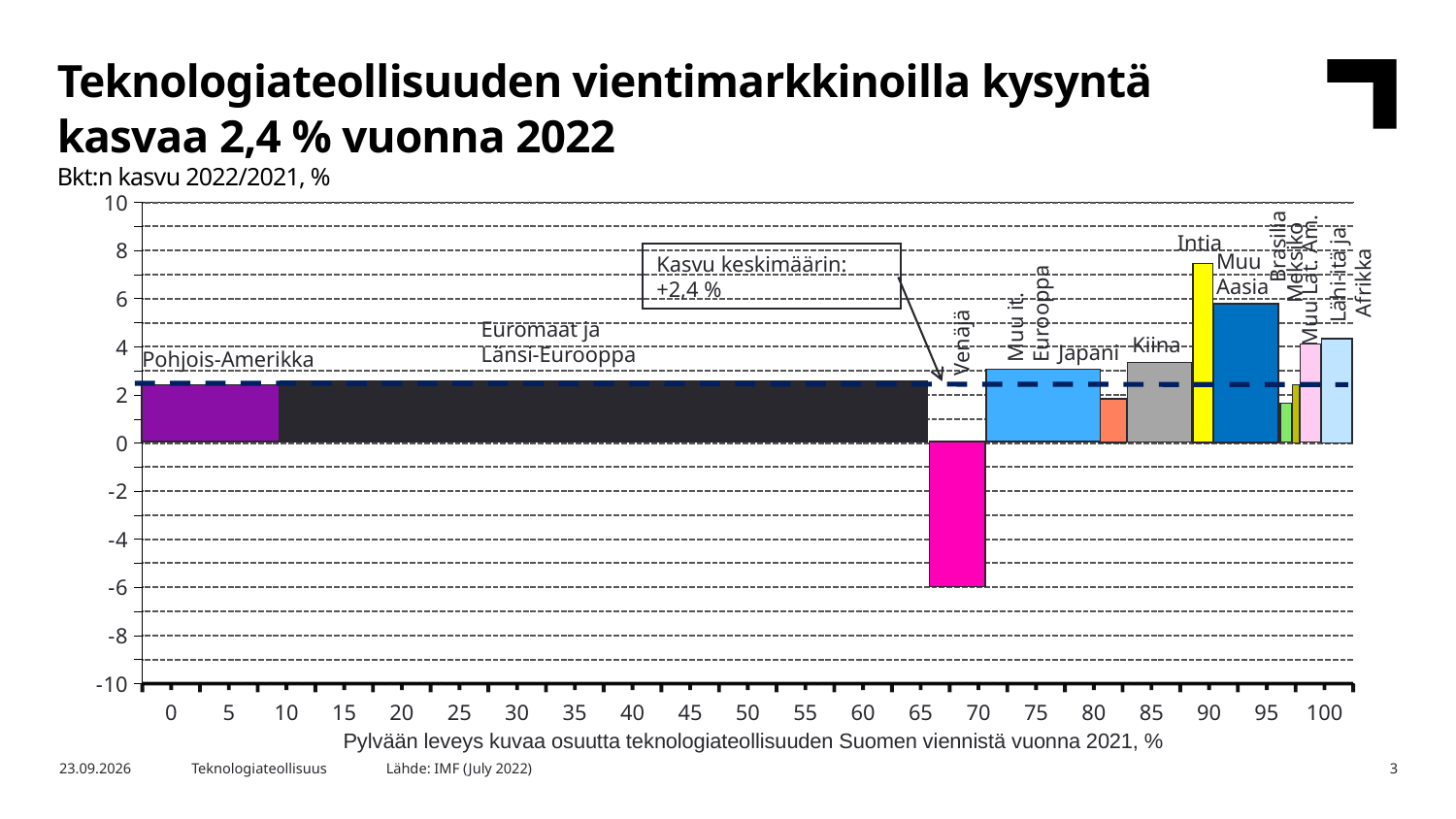
What average growth value is indicated by the dashed line annotation on the chart? +2,4 % What kind of chart is shown on the slide? bar chart Which category has the highest GDP growth value in the chart? Intia Which has the larger value, Lähi-itä ja Afrikka or Japani? Lähi-itä ja Afrikka How many categories (bars) are shown in the chart? 12 Is the value for Muu Aasia greater or less than 4? greater Which category has the lowest GDP growth value in the chart? Venäjä Is the value for Venäjä greater or less than 0? less Which has the larger value, Intia or Kiina? Intia Is the value for Intia greater or less than 6? greater